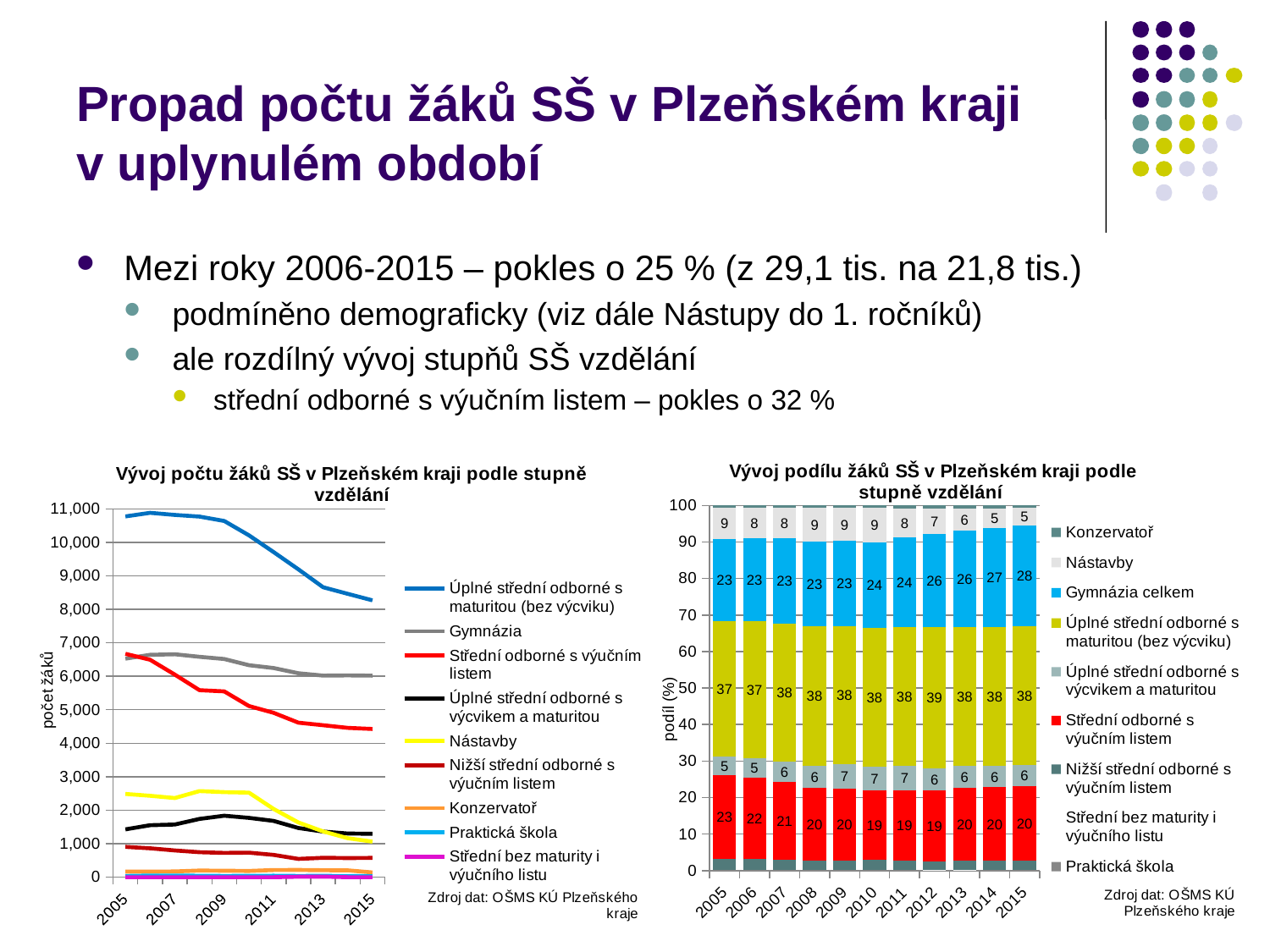
How many years (bars) are shown in the right chart (Vývoj podílu žáků SŠ)? 11 In the left chart (Vývoj počtu žáků SŠ), which is larger in 2015: Gymnázia or Střední odborné s výučním listem? Gymnázia In the right chart (Vývoj podílu žáků SŠ), what is the share of Nástavby in 2005? 9 What kind of chart is the left chart, 'Vývoj počtu žáků SŠ v Plzeňském kraji podle stupně vzdělání'? line chart In the right chart (Vývoj podílu žáků SŠ), what is the share of Střední odborné s výučním listem in 2007? 21 In the left chart (Vývoj počtu žáků SŠ), does the line for Střední odborné s výučním listem rise or fall from 2005 to 2015? fall In the left chart (Vývoj počtu žáků SŠ), is the value for Úplné střední odborné s maturitou (bez výcviku) in 2015 greater or less than 9,000? less In the right chart (Vývoj podílu žáků SŠ), in which year is the share of Úplné střední odborné s maturitou (bez výcviku) highest? 2012 How many series does the legend of the left chart (Vývoj počtu žáků SŠ) list? 9 What kind of chart is the right chart, 'Vývoj podílu žáků SŠ v Plzeňském kraji podle stupně vzdělání'? stacked bar chart In the right chart (Vývoj podílu žáků SŠ), by how many percentage points did the share of Gymnázia celkem increase from 2005 to 2015? 5 In the right chart (Vývoj podílu žáků SŠ), what is the share of Gymnázia celkem in 2015? 28